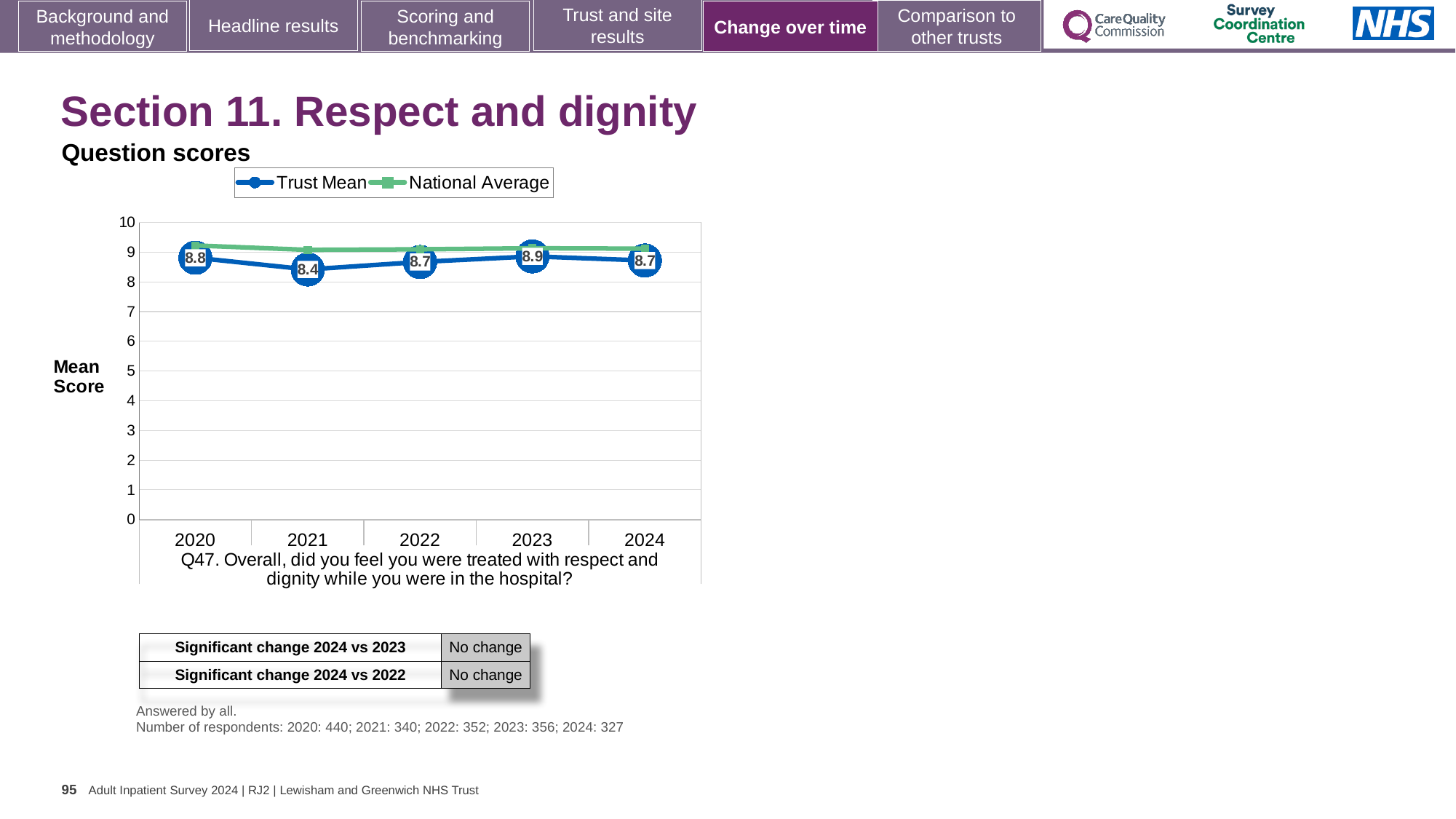
What is the Trust Mean score for 2020? 8.8 Is the National Average value for 2021 greater or less than 8? greater What is the difference between the Trust Mean score in 2023 and in 2021? 0.5 How many series does the legend list? 2 What kind of chart is shown on the slide? Line chart Does the Trust Mean score rise or fall from 2020 to 2021? Fall What is the Trust Mean score for 2021? 8.4 In which year is the Trust Mean score lowest? 2021 Which is larger, the Trust Mean score for 2020 or for 2021? 2020 How many years are shown on the x axis? 5 In which year is the Trust Mean score highest? 2023 What is the Trust Mean score for 2024? 8.7